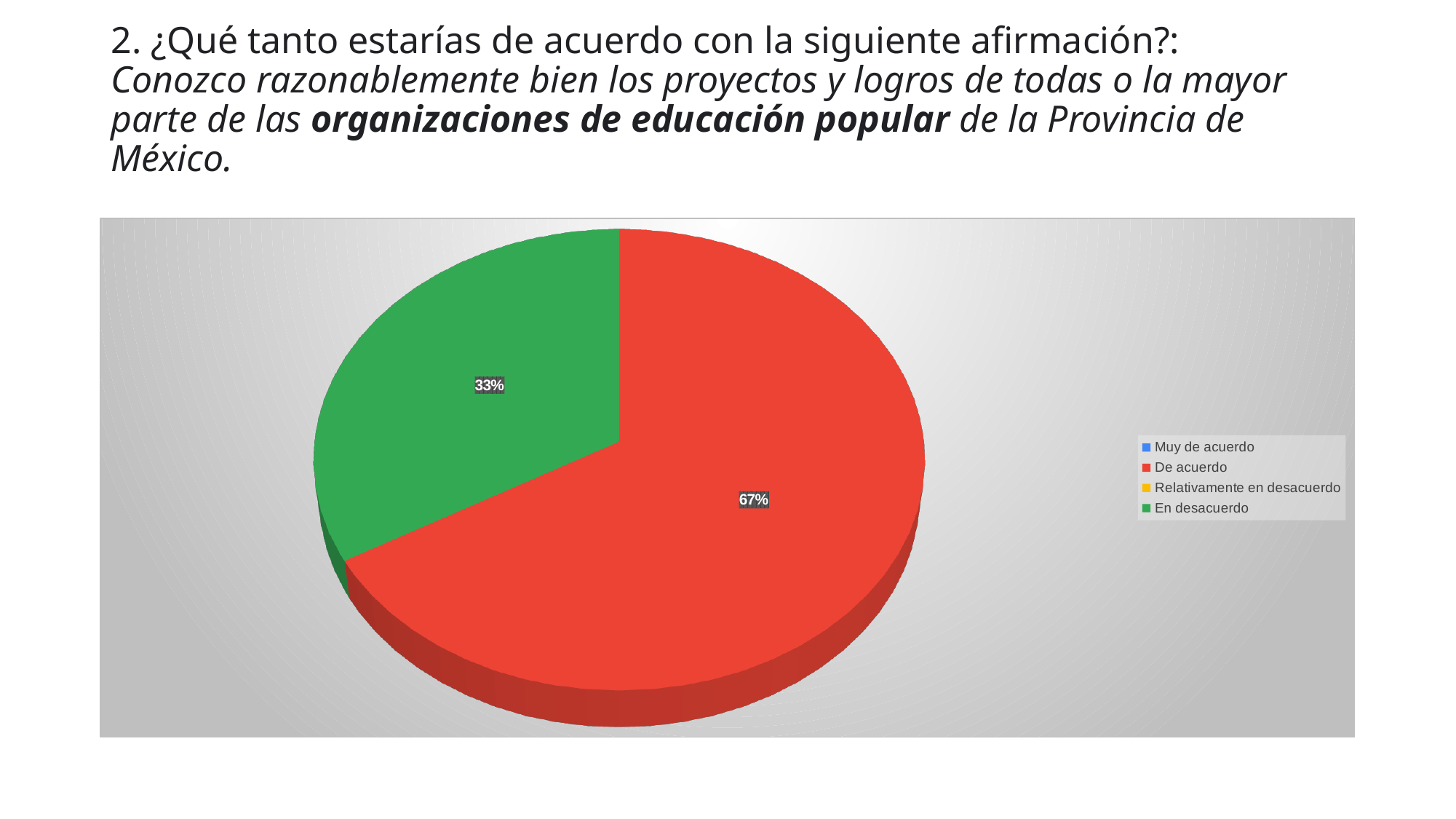
What share of the pie does "De acuerdo" represent? 67% What colour is the "En desacuerdo" slice? green What colour is the "De acuerdo" slice? red How many categories does the legend list? 4 Is the share for "De acuerdo" greater or less than 50%? greater What share of the pie does "En desacuerdo" represent? 33% What kind of chart is shown on the slide? pie chart Which category has the largest slice of the pie? De acuerdo How many slices are visible in the pie? 2 What is the difference in percentage points between the "De acuerdo" and "En desacuerdo" slices? 34 Is the share for "En desacuerdo" greater or less than 50%? less Which of the two visible slices is larger, "De acuerdo" or "En desacuerdo"? De acuerdo